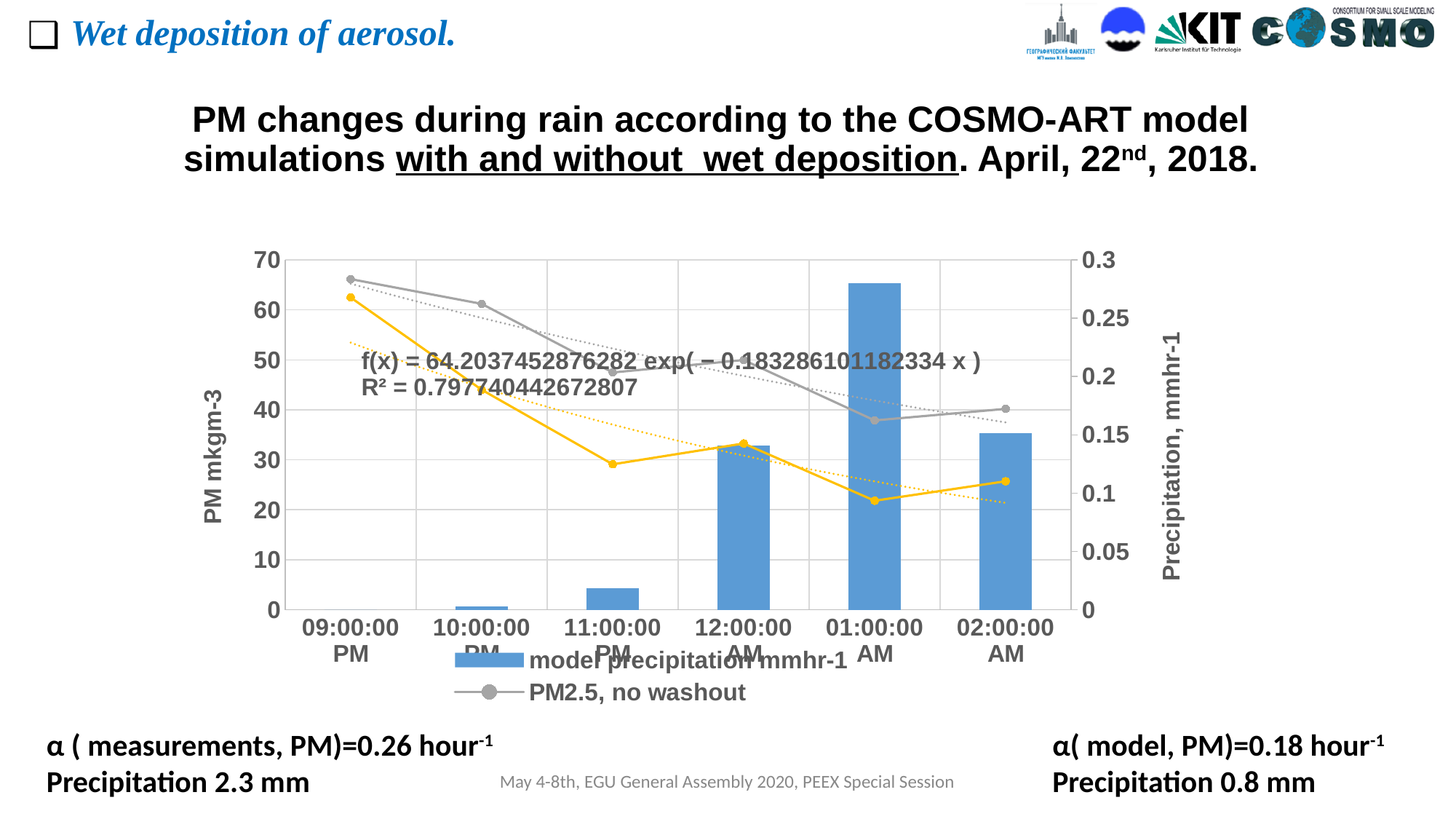
Does the PM2.5, no washout line generally rise or fall from 09:00:00 PM to 02:00:00 AM? fall Is the PM2.5, no washout value at 09:00:00 PM greater or less than 60? greater At which time is the model precipitation bar highest? 01:00:00 AM How many series does the legend list? 2 At which time is the PM2.5, no washout value highest? 09:00:00 PM Is the model precipitation value at 01:00:00 AM greater or less than 0.25? greater Which is larger, the model precipitation bar at 01:00:00 AM or at 02:00:00 AM? 01:00:00 AM Is the PM2.5, no washout value at 01:00:00 AM greater or less than 50? less How many time categories are shown on the x axis? 6 What is the label of the right-hand vertical axis? Precipitation, mmhr-1 What kind of chart is shown on the slide? A combined bar and line chart